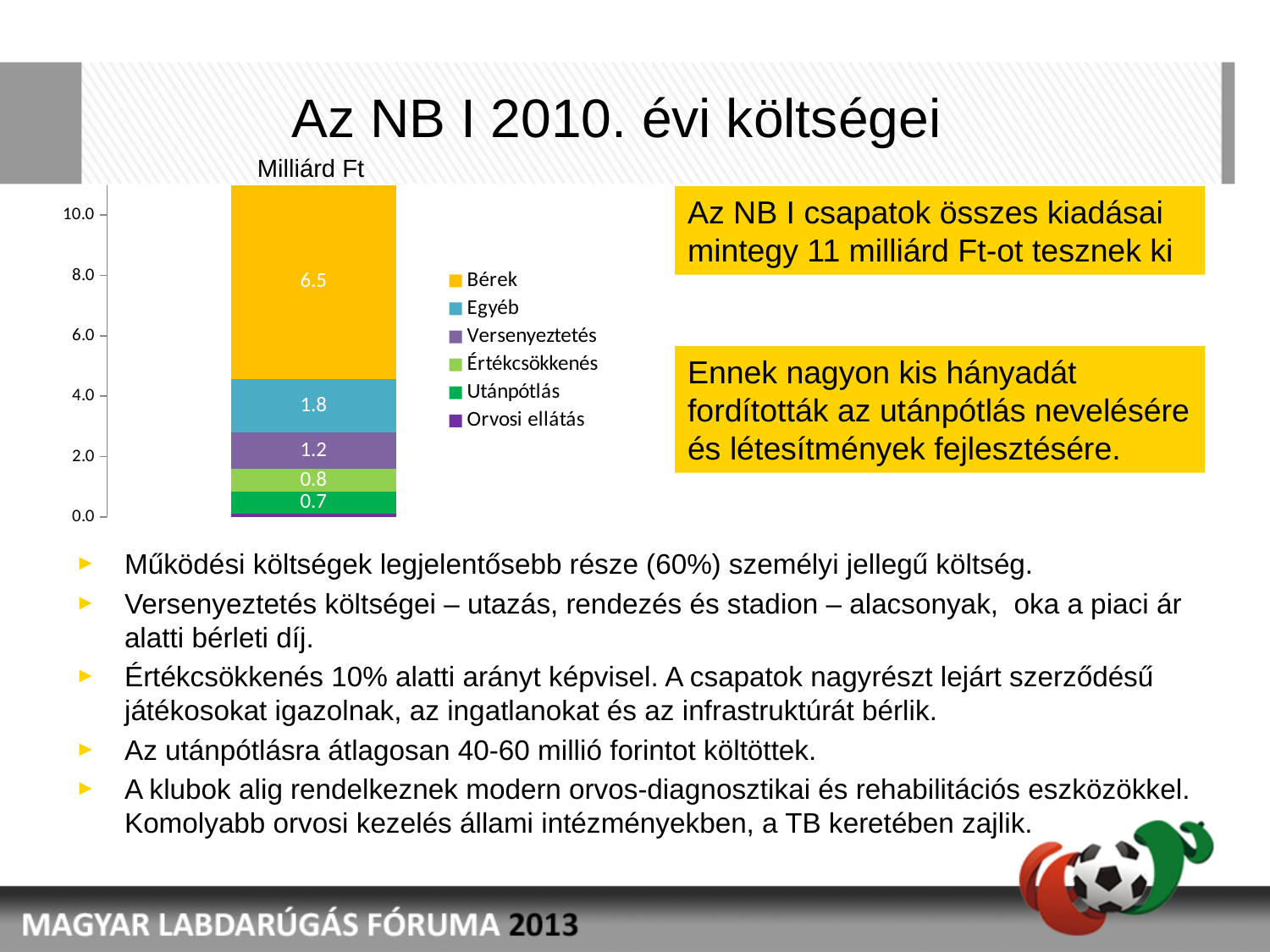
What is the value of the Utánpótlás segment in the stacked bar? 0.7 What is the difference between the Bérek segment and the Egyéb segment? 4.7 What is the value of the Versenyeztetés segment in the stacked bar? 1.2 What is the value of the Egyéb segment in the stacked bar? 1.8 Which cost category has the largest segment in the stacked bar? Bérek What unit is shown above the chart's vertical axis? Milliárd Ft Which is larger, the Egyéb segment or the Versenyeztetés segment? Egyéb What is the value of the Bérek segment in the stacked bar? 6.5 Which cost category has the smallest segment in the stacked bar? Orvosi ellátás Is the total height of the stacked bar greater or less than 10.0? greater How many series does the legend list? 6 What kind of chart is shown on the slide? Stacked bar chart